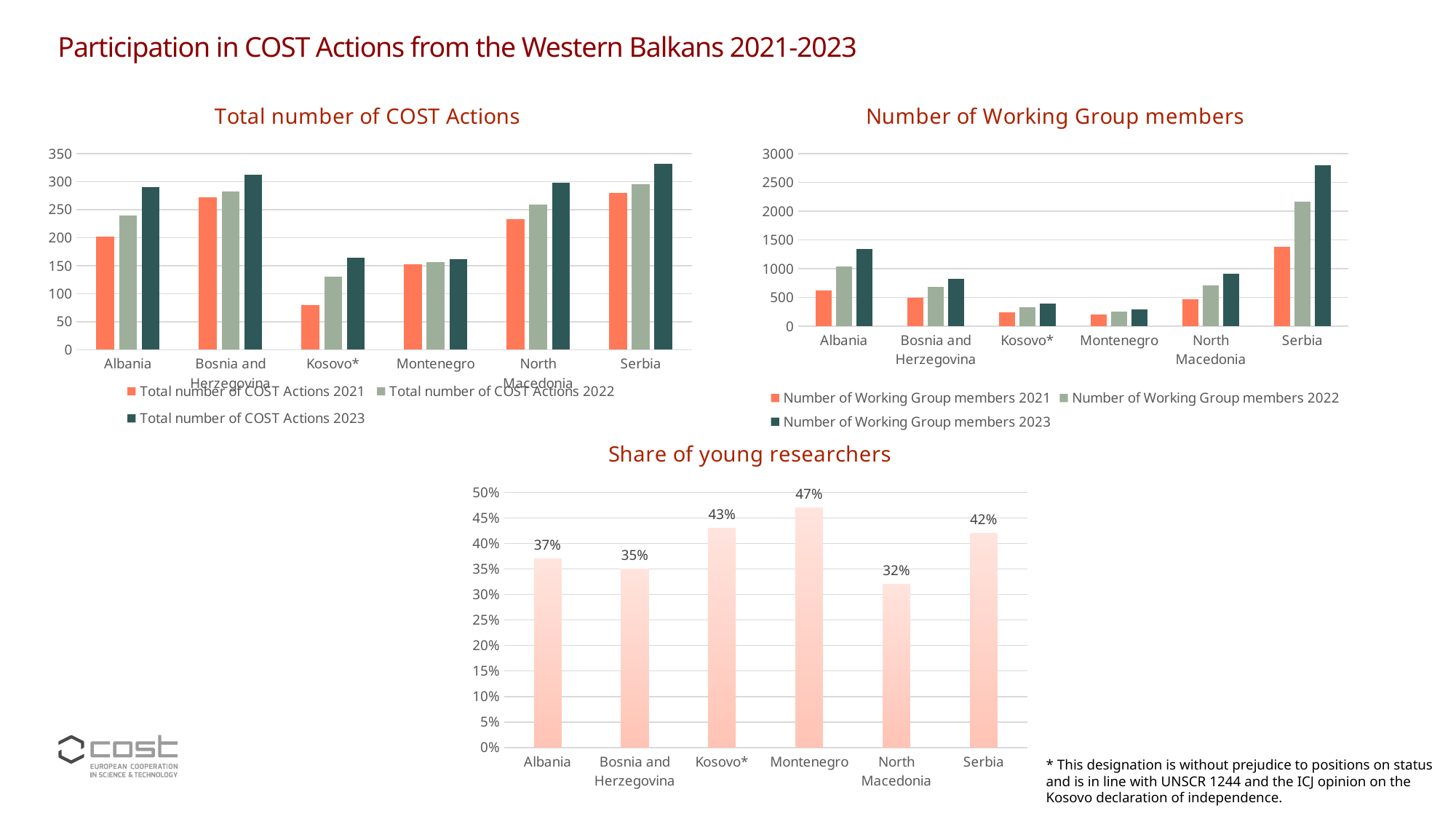
In the 'Share of young researchers' chart, which country has the lowest share? North Macedonia How many series does the legend of the 'Number of Working Group members' chart list? 3 In the 'Total number of COST Actions' chart, is the value for Serbia in 2023 greater or less than 300? greater In the 'Share of young researchers' chart, what is the share for Montenegro? 47% In the 'Share of young researchers' chart, what is the difference between the shares for Kosovo* and Bosnia and Herzegovina? 8% In the 'Share of young researchers' chart, which is larger, the share for Serbia or the share for Albania? Serbia In the 'Number of Working Group members' chart, is the value for Kosovo* in 2023 greater or less than 500? less In the 'Total number of COST Actions' chart, which country has the lowest value for 2021? Kosovo* In the 'Share of young researchers' chart, which country has the highest share? Montenegro How many countries are shown on the x axis of the 'Total number of COST Actions' chart? 6 In the 'Share of young researchers' chart, what is the share for North Macedonia? 32% In the 'Number of Working Group members' chart, which country has the highest value for 2023? Serbia